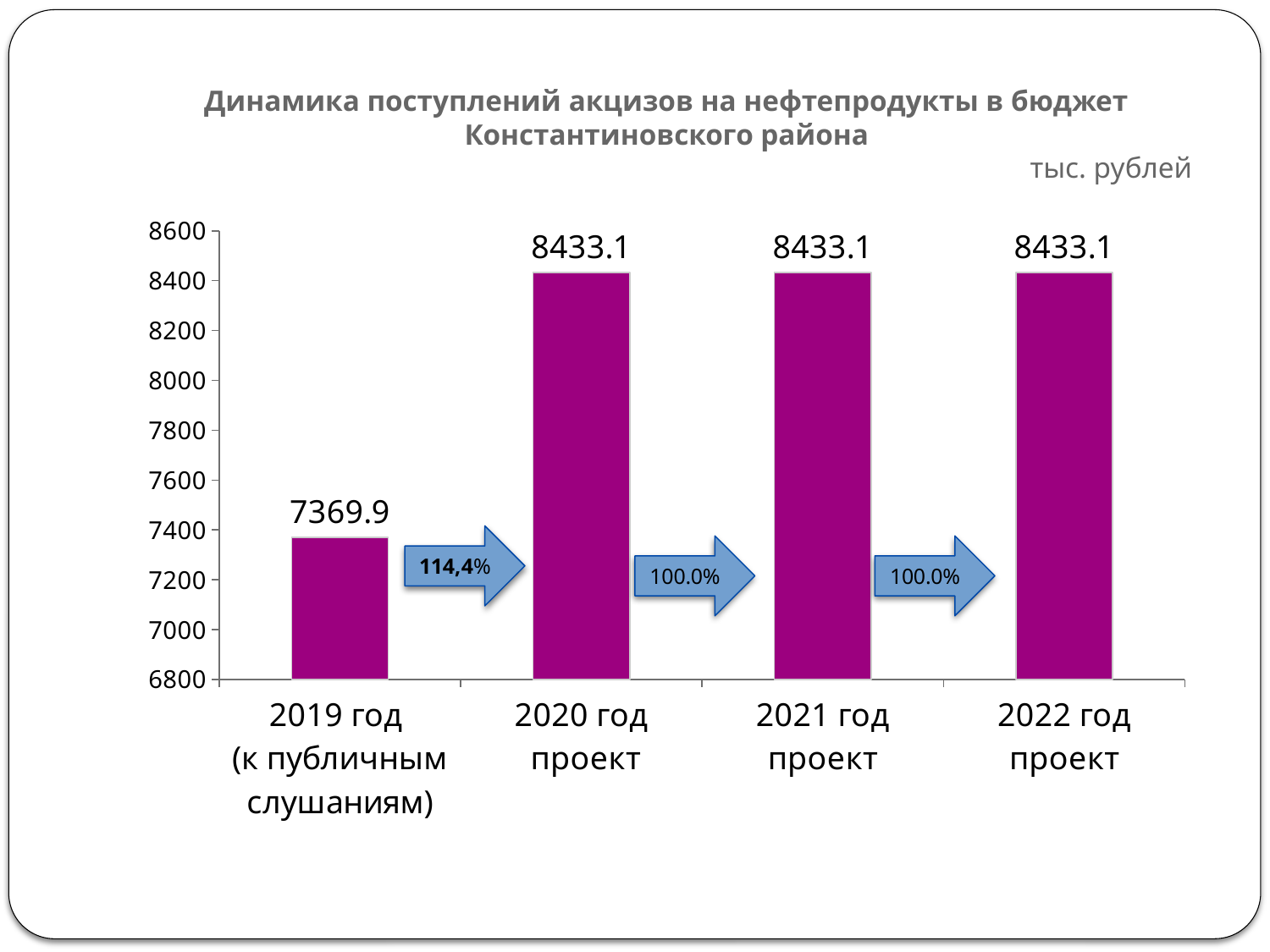
What is the difference between the values for 2020 год проект and 2019 год (к публичным слушаниям)? 1063.2 What is the value for 2019 год (к публичным слушаниям)? 7369.9 Is the value for 2019 год (к публичным слушаниям) greater or less than 7400? less Which category has the lowest value? 2019 год (к публичным слушаниям) What unit of measurement is indicated above the chart? тыс. рублей How many categories are shown on the x axis? 4 Which is larger, the value for 2019 год (к публичным слушаниям) or the value for 2021 год проект? 2021 год проект Is the value for 2021 год проект greater or less than 8200? greater What is the value for 2020 год проект? 8433.1 What kind of chart is shown on the slide? bar chart What is the value for 2022 год проект? 8433.1 What percentage is shown on the arrow between 2019 год and 2020 год проект? 114,4%